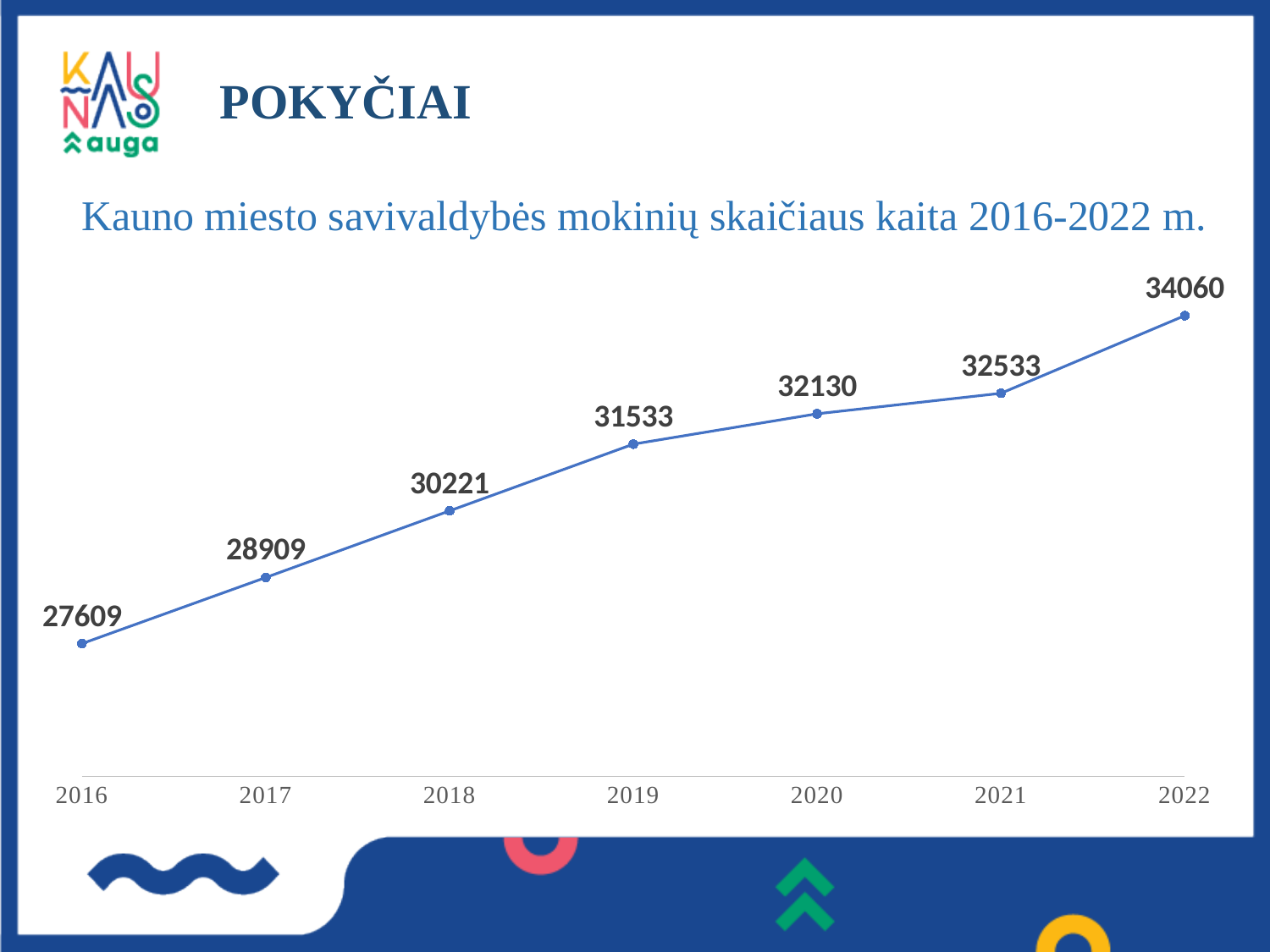
Which year has the highest value? 2022 Which is larger, the value for 2020 or the value for 2021? 2021 What is the title of the chart? Kauno miesto savivaldybės mokinių skaičiaus kaita 2016-2022 m. What is the difference between the values for 2018 and 2017? 1312 Which year has the lowest value? 2016 What is the value for 2022? 34060 What is the value for 2016? 27609 Do the values rise or fall from 2016 to 2022? rise What kind of chart is shown? line chart What is the difference between the values for 2022 and 2016? 6451 How many years are plotted on the chart? 7 What is the value for 2019? 31533